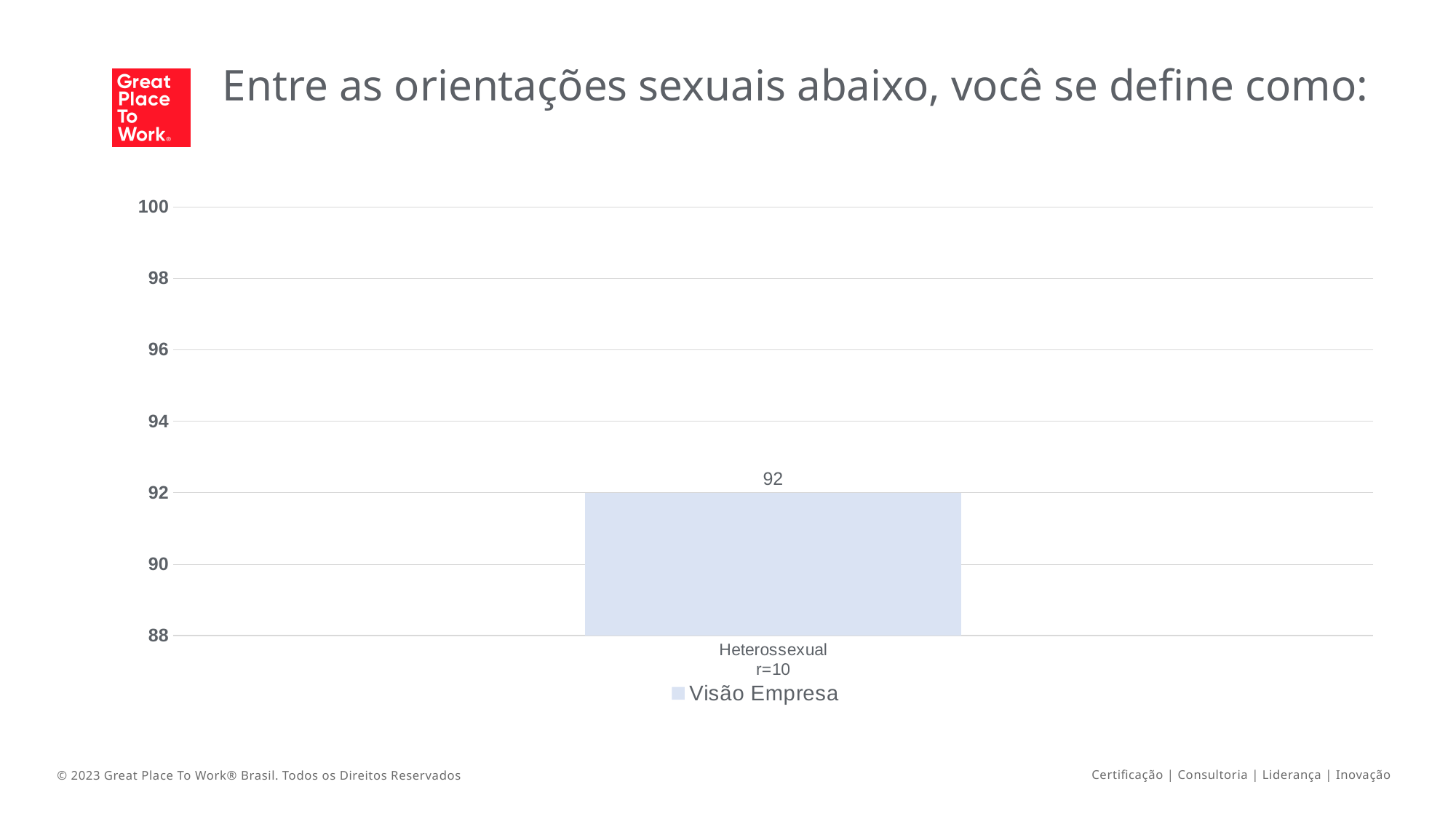
How many series does the legend list? 1 What is the lowest value shown on the vertical axis? 88 What is the value for Heterossexual? 92 Is the value for Heterossexual greater or less than 94? less What is the name of the series shown in the legend? Visão Empresa What is the respondent count (r) shown under the Heterossexual category? r=10 How many categories are plotted on the chart? 1 Is the value for Heterossexual greater or less than 90? greater What is the highest value shown on the vertical axis? 100 What kind of chart is shown on the slide? bar chart What is the title of the chart? Entre as orientações sexuais abaixo, você se define como: